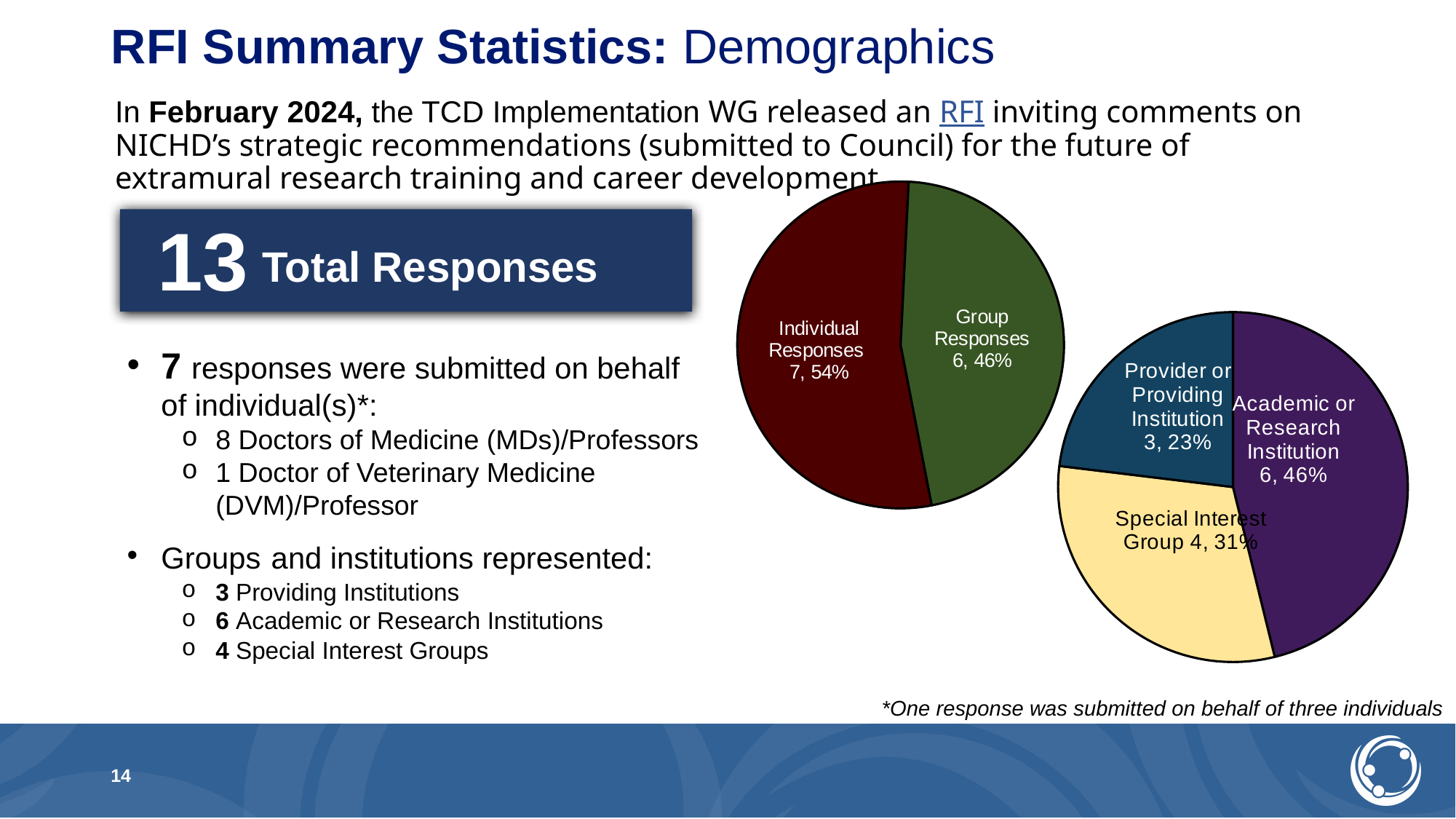
In the left pie chart, how many Individual Responses are shown? 7 In the left pie chart, what is the difference between the number of Individual Responses and Group Responses? 1 In the right pie chart, how many responses came from a Provider or Providing Institution? 3 In the right pie chart, which category has the smallest slice? Provider or Providing Institution In the left pie chart, what percentage share do Group Responses have? 46% What type of chart is the left chart on the slide? Pie chart In the left pie chart, which slice is larger, Individual Responses or Group Responses? Individual Responses How many slices does the right pie chart have? 3 In the right pie chart, what is the difference between the Academic or Research Institution count and the Special Interest Group count? 2 How many slices does the left pie chart have? 2 In the right pie chart, what percentage share does Special Interest Group have? 31% In the right pie chart, which category has the largest slice? Academic or Research Institution